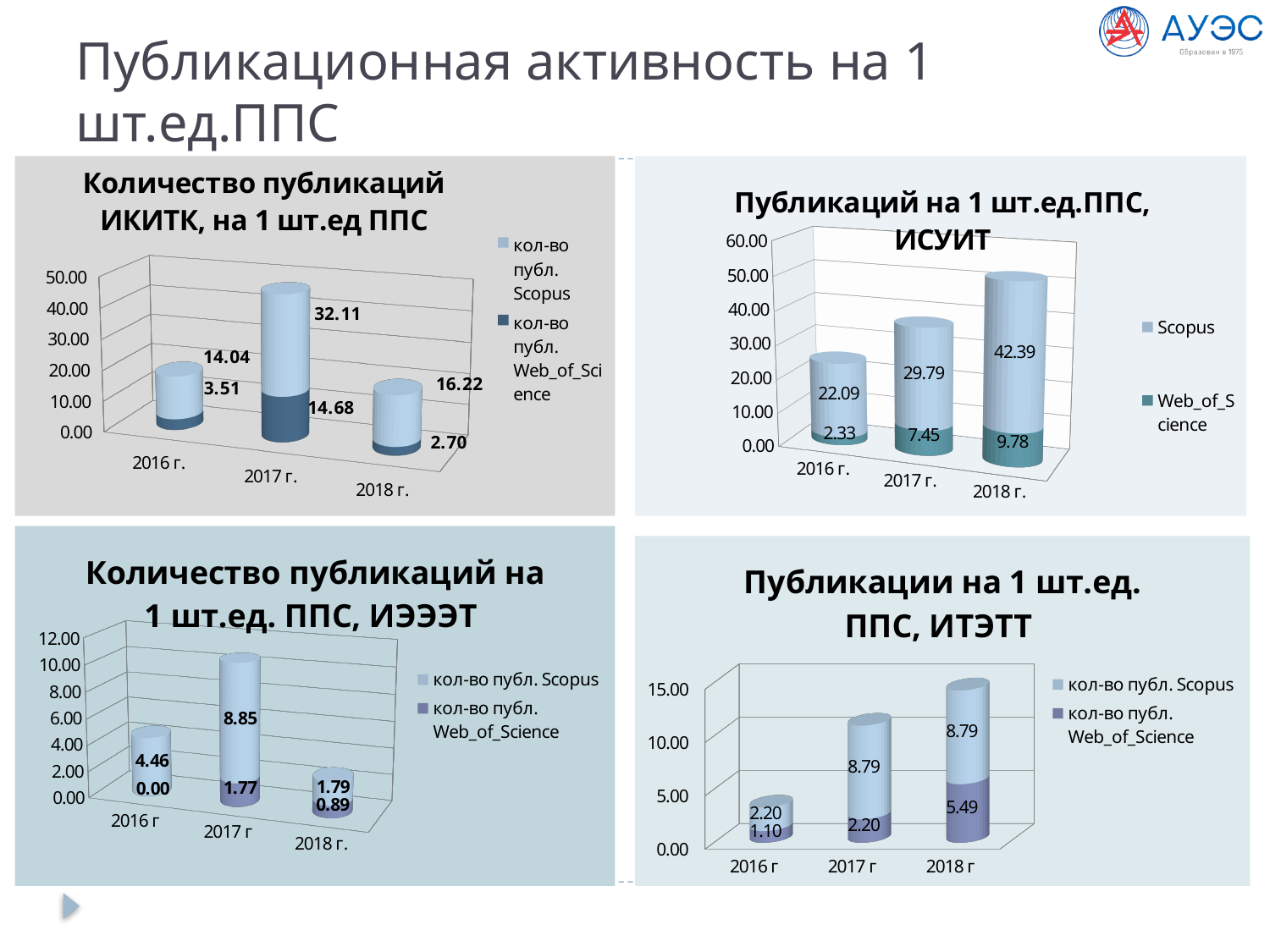
In the bottom-right chart (Публикации на 1 шт.ед. ППС, ИТЭТТ), which is larger: the Web_of_Science value for 2017 г or for 2018 г? 2018 г In the bottom-left chart (Количество публикаций на 1 шт.ед. ППС, ИЭЭЭТ), what is the Web_of_Science value for 2016 г? 0.00 In the bottom-right chart (Публикации на 1 шт.ед. ППС, ИТЭТТ), what is the Web_of_Science value for 2018 г? 5.49 In the top-right chart (Публикаций на 1 шт.ед.ППС, ИСУИТ), do the Scopus values rise or fall from 2016 г. to 2018 г.? rise In the top-left chart (Количество публикаций ИКИТК, на 1 шт.ед ППС), what is the Scopus value for 2017 г.? 32.11 In the top-left chart (Количество публикаций ИКИТК, на 1 шт.ед ППС), what is the total of the stacked bar for 2016 г.? 17.55 How many series does the legend of the bottom-right chart (Публикации на 1 шт.ед. ППС, ИТЭТТ) list? 2 In the bottom-left chart (Количество публикаций на 1 шт.ед. ППС, ИЭЭЭТ), which year has the lowest Scopus value? 2018 г. In the top-right chart (Публикаций на 1 шт.ед.ППС, ИСУИТ), what is the difference between the Scopus values for 2018 г. and 2016 г.? 20.30 In the top-left chart (Количество публикаций ИКИТК, на 1 шт.ед ППС), what is the Web_of_Science value for 2018 г.? 2.70 In the top-right chart (Публикаций на 1 шт.ед.ППС, ИСУИТ), what is the Web_of_Science value for 2017 г.? 7.45 In the top-right chart (Публикаций на 1 шт.ед.ППС, ИСУИТ), which year has the highest Scopus value? 2018 г.